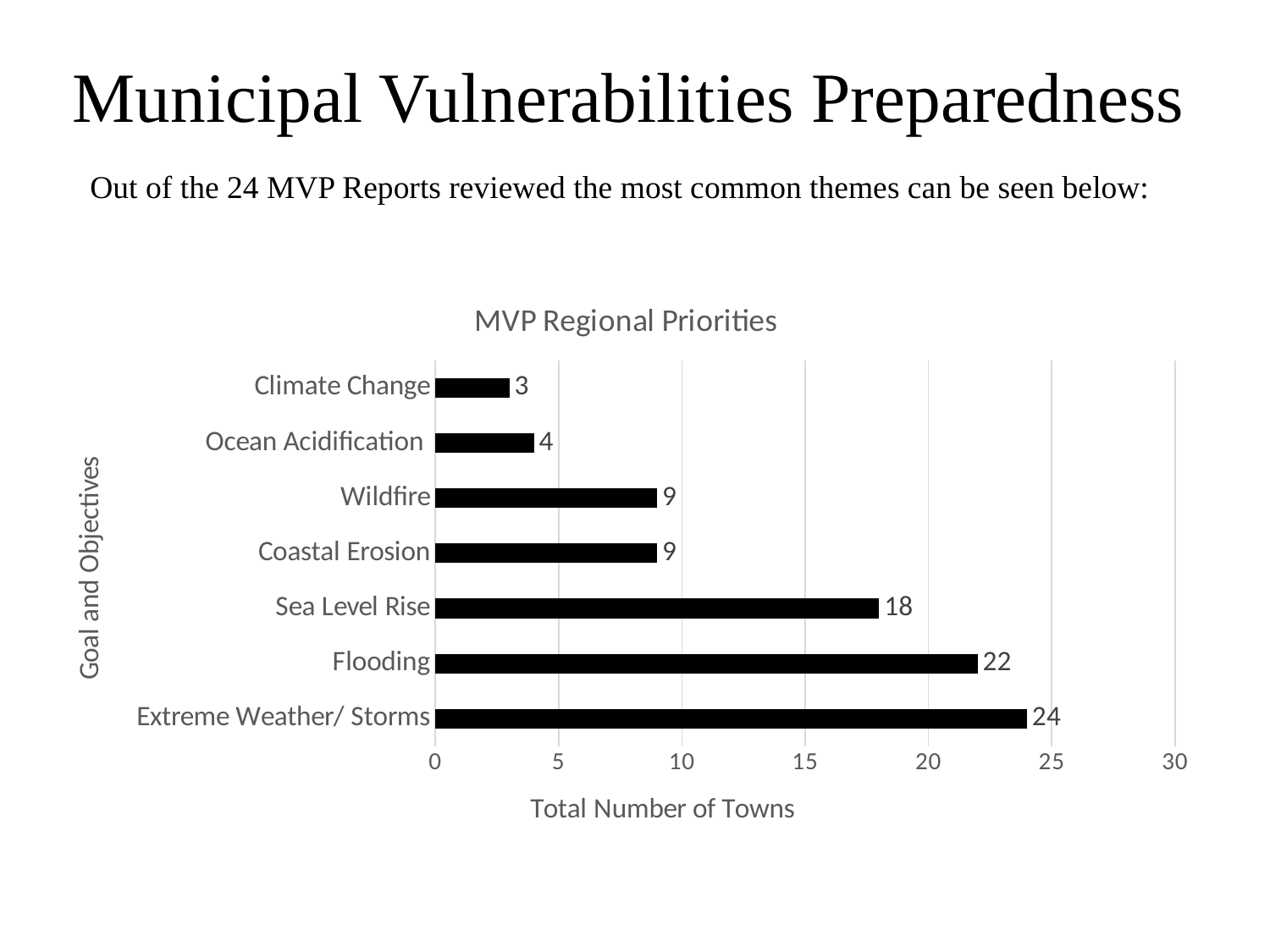
Is the value for Flooding greater or less than 20? greater What is the difference between the values for Sea Level Rise and Wildfire? 9 What is the value for Sea Level Rise? 18 What is the value for Ocean Acidification? 4 What is the value for Flooding? 22 What is the title of the chart? MVP Regional Priorities Which is larger, the value for Sea Level Rise or the value for Coastal Erosion? Sea Level Rise Which category has the highest value? Extreme Weather/ Storms What kind of chart is shown on the slide? bar chart How many categories are shown in the chart? 7 Which category has the lowest value? Climate Change What is the difference between the values for Extreme Weather/ Storms and Flooding? 2